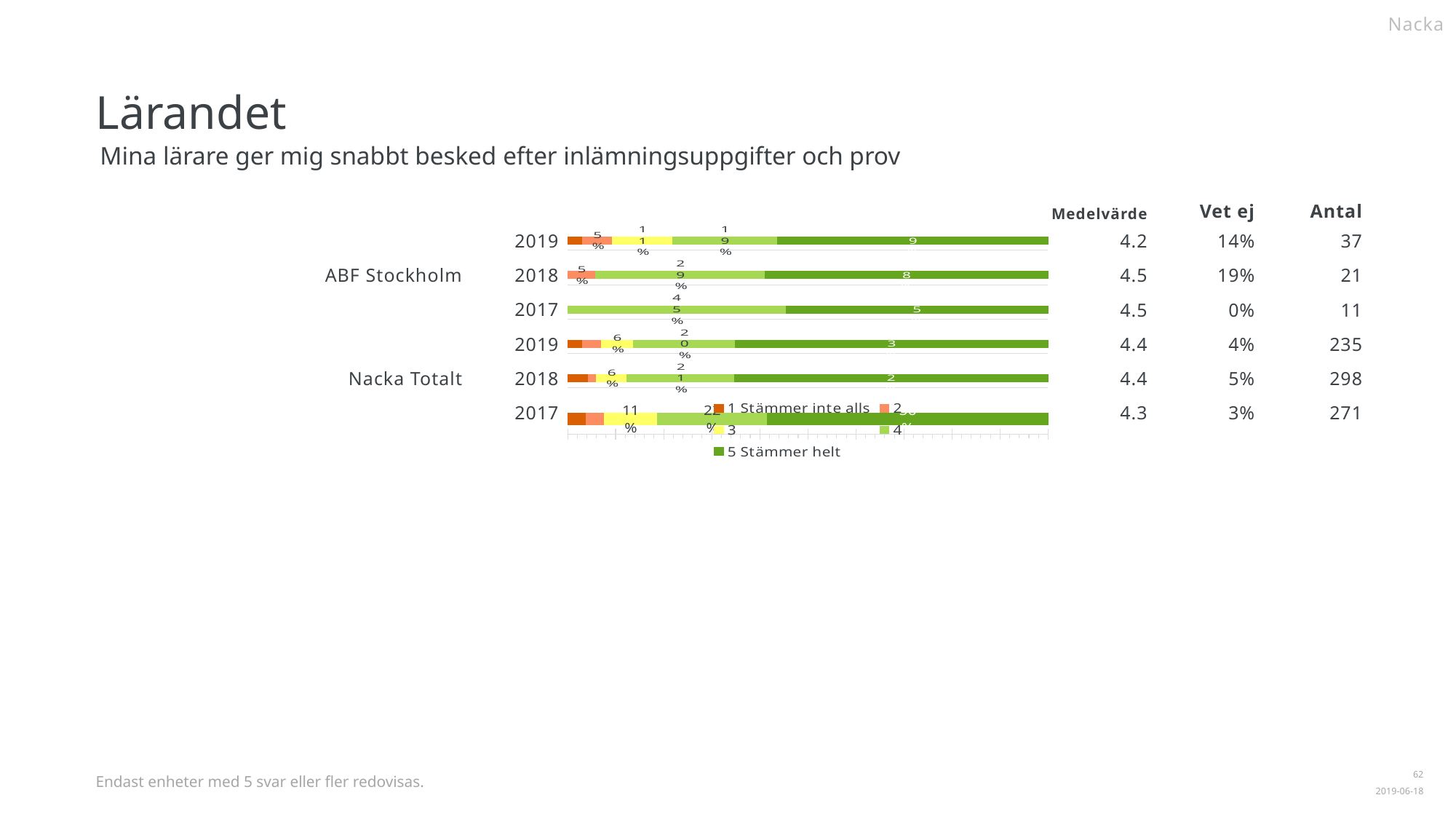
Which bar has the largest '4' segment? ABF Stockholm 2017 How many bars are plotted in the chart? 6 What is the value of the '4' segment for ABF Stockholm 2018? 29% What is the label of the last legend entry in the chart? 5 Stämmer helt What kind of chart is shown on the slide? stacked bar chart What is the label of the first legend entry in the chart? 1 Stämmer inte alls What is the value of the '3' segment for ABF Stockholm 2019? 11% Which is larger, the '4' segment for ABF Stockholm 2017 or for ABF Stockholm 2018? ABF Stockholm 2017 What is the value of the '4' segment for Nacka Totalt 2019? 20% How many series does the chart legend list? 5 What is the value of the '4' segment for ABF Stockholm 2017? 45%